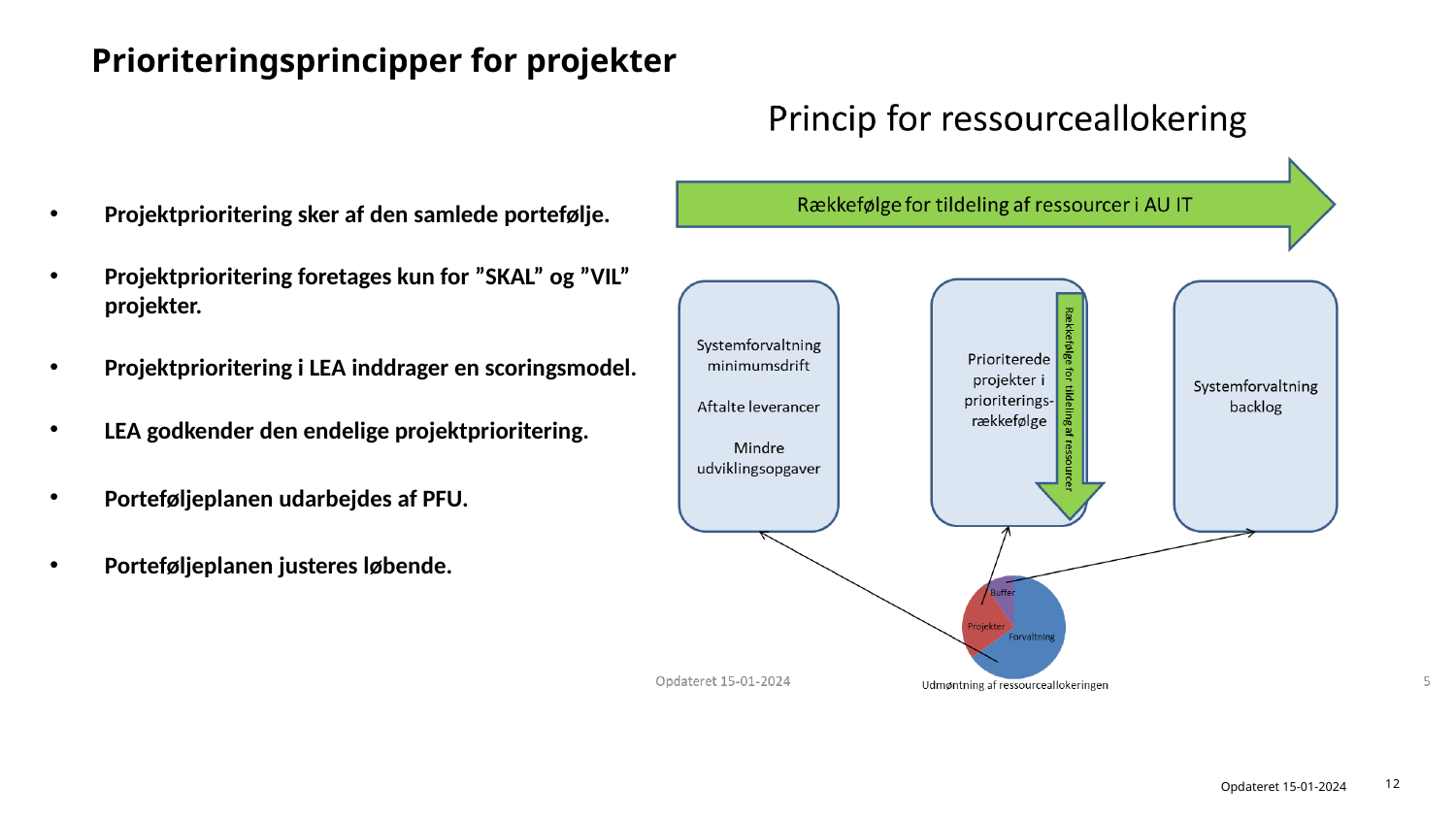
What kind of chart is shown at the bottom of the slide under the diagram? pie chart In the pie chart, which is larger: Forvaltning or Projekter? Forvaltning Which slice of the pie chart is the smallest? Buffer What caption is written below the pie chart? Udmøntning af ressourceallokeringen How many slices does the pie chart have? 3 Which slice of the pie chart is the largest? Forvaltning What colour is the Forvaltning slice of the pie chart? blue In the pie chart, which is larger: Projekter or Buffer? Projekter